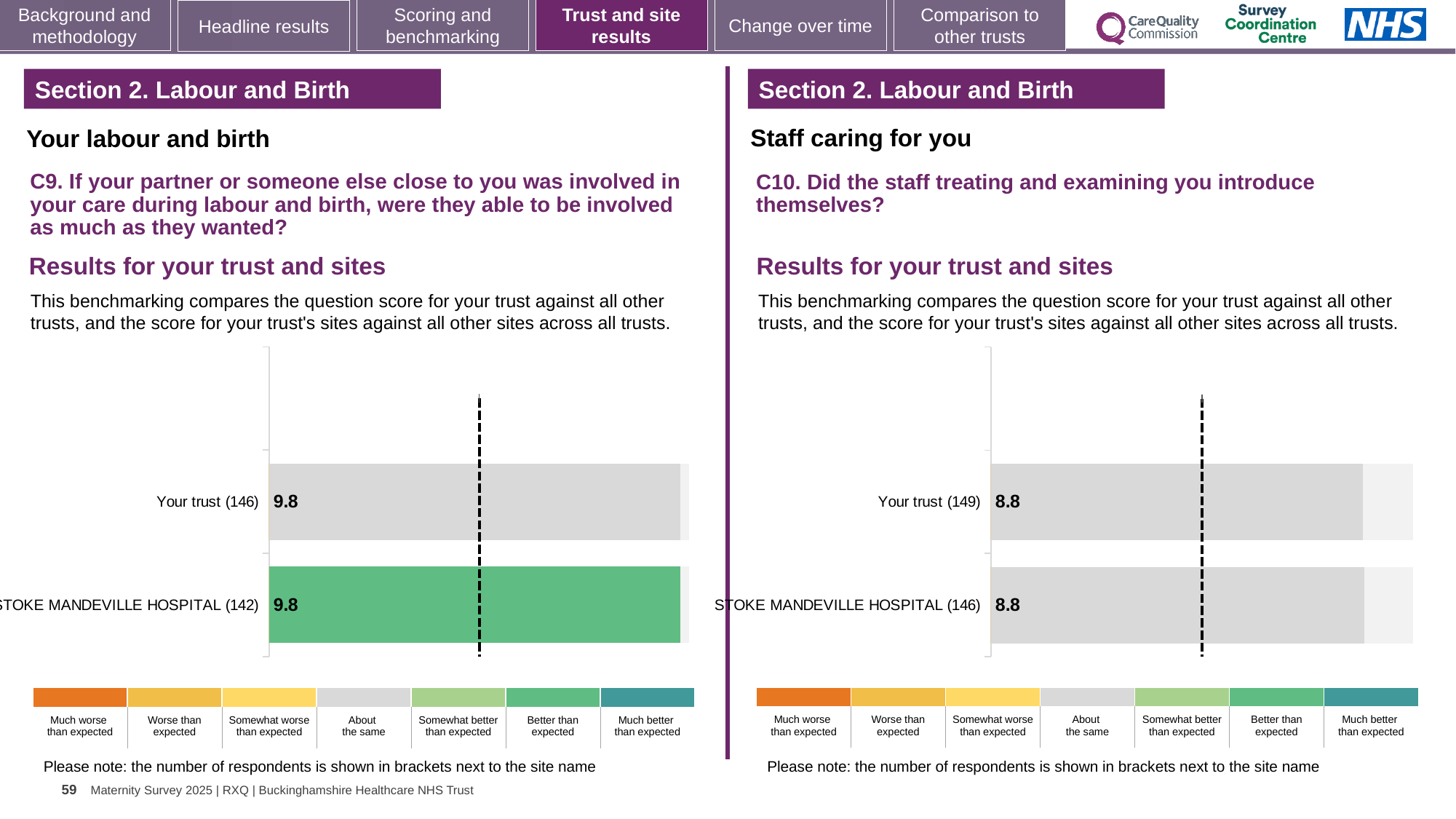
In the C9 chart on the left, which benchmark category does the colour of the STOKE MANDEVILLE HOSPITAL bar correspond to? Better than expected In the C9 chart on the left, what is the score for STOKE MANDEVILLE HOSPITAL (142)? 9.8 How many bars are plotted in the C9 chart on the left? 2 In the C10 chart on the right, what is the score for STOKE MANDEVILLE HOSPITAL (146)? 8.8 How many bars are plotted in the C10 chart on the right? 2 How many respondents are shown in brackets for Your trust in the C10 chart on the right? 149 In the C10 chart on the right, which benchmark category does the colour of the Your trust bar correspond to? About the same What kind of chart is used for the C9 results on the left? Bar chart In the C9 chart on the left, what is the difference between the score for Your trust and the score for STOKE MANDEVILLE HOSPITAL? 0.0 In the C10 chart on the right, what is the difference between the score for Your trust and the score for STOKE MANDEVILLE HOSPITAL? 0.0 In the C9 chart on the left, what is the score for Your trust (146)? 9.8 In the C10 chart on the right, what is the score for Your trust (149)? 8.8